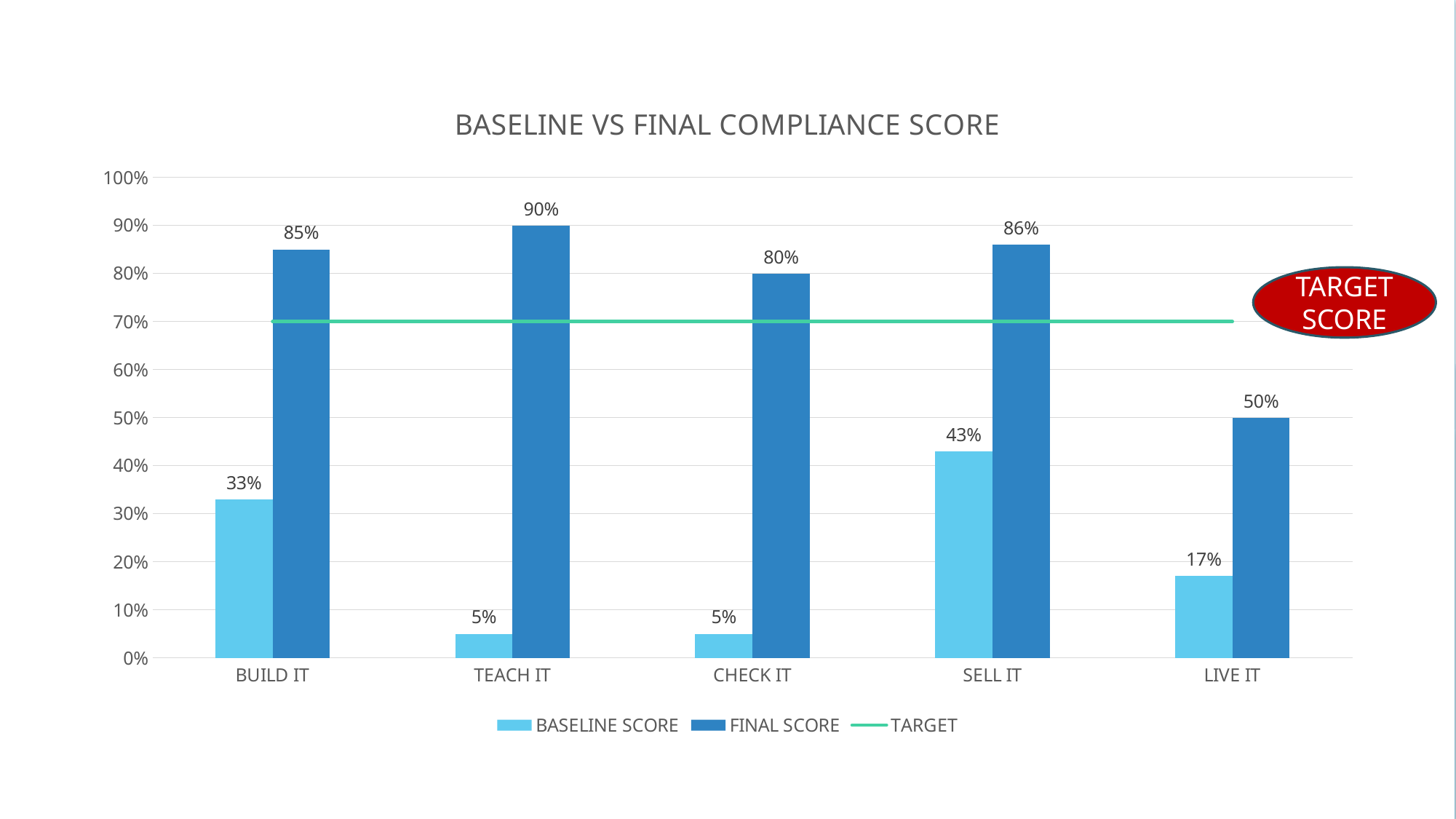
Which category has the lowest FINAL SCORE? LIVE IT How many series does the legend list? 3 Which is larger, the FINAL SCORE for CHECK IT or the FINAL SCORE for SELL IT? SELL IT How many categories are shown on the x axis? 5 What is the FINAL SCORE for TEACH IT? 90% Is the TARGET line greater or less than 60%? greater Which category has the highest FINAL SCORE? TEACH IT What is the difference between the FINAL SCORE and the BASELINE SCORE for BUILD IT? 52% Which category has the highest BASELINE SCORE? SELL IT What is the BASELINE SCORE for SELL IT? 43% What is the BASELINE SCORE for LIVE IT? 17% What is the title of the chart? BASELINE VS FINAL COMPLIANCE SCORE